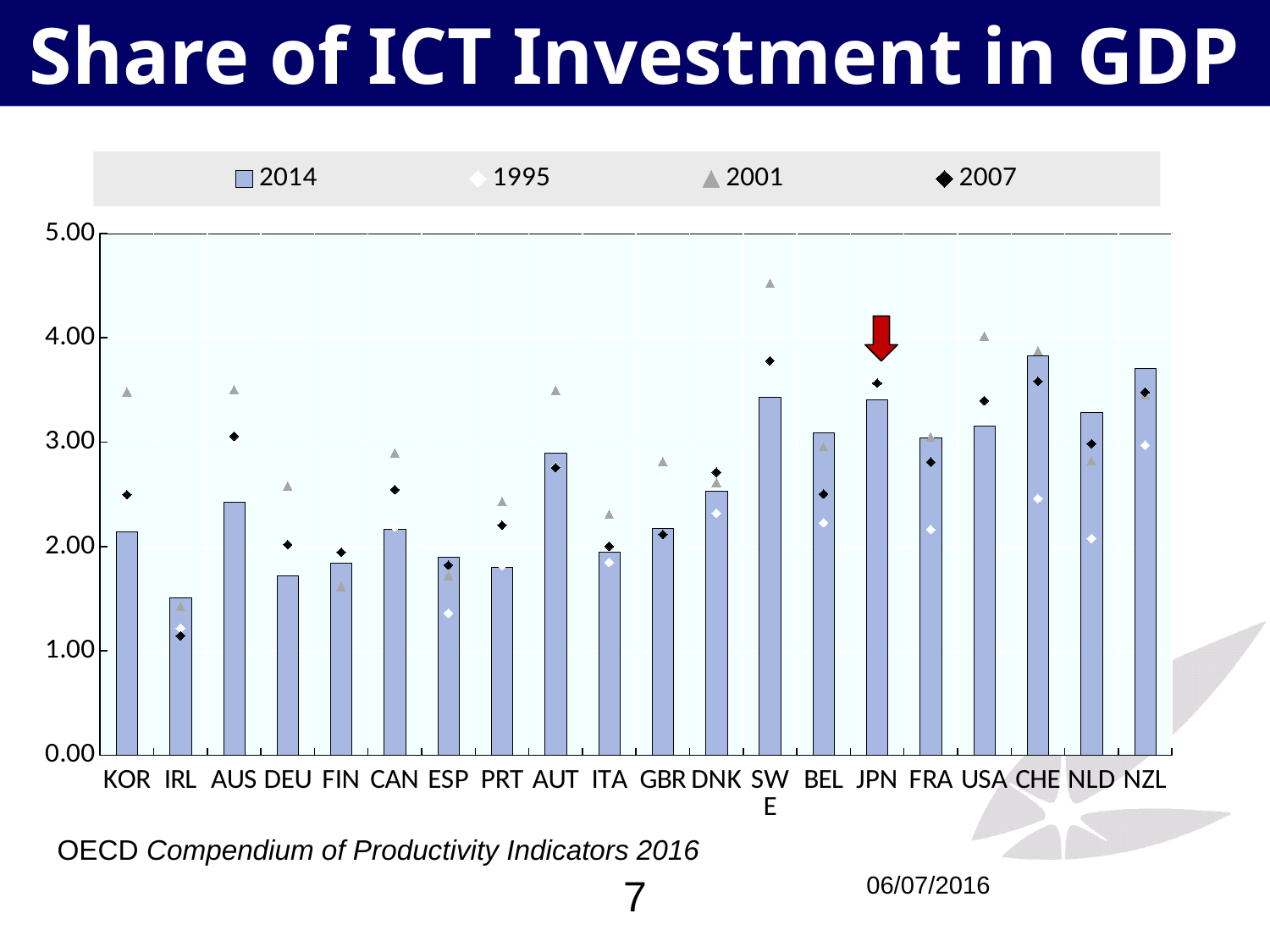
Is the 2014 value for IRL greater or less than 2.00? less What kind of chart is shown on the slide? bar chart Is the 2014 value for JPN greater or less than 3.00? greater Which year is represented by the bars in the chart? 2014 How many series does the legend list? 4 Is the 2001 value for SWE greater or less than 4.00? greater Which country has the highest 2001 marker? SWE Which has the larger 2014 value, SWE or KOR? SWE Which country does the red arrow on the chart point to? JPN Which country has the lowest 2014 bar? IRL How many countries are shown on the x axis of the chart? 20